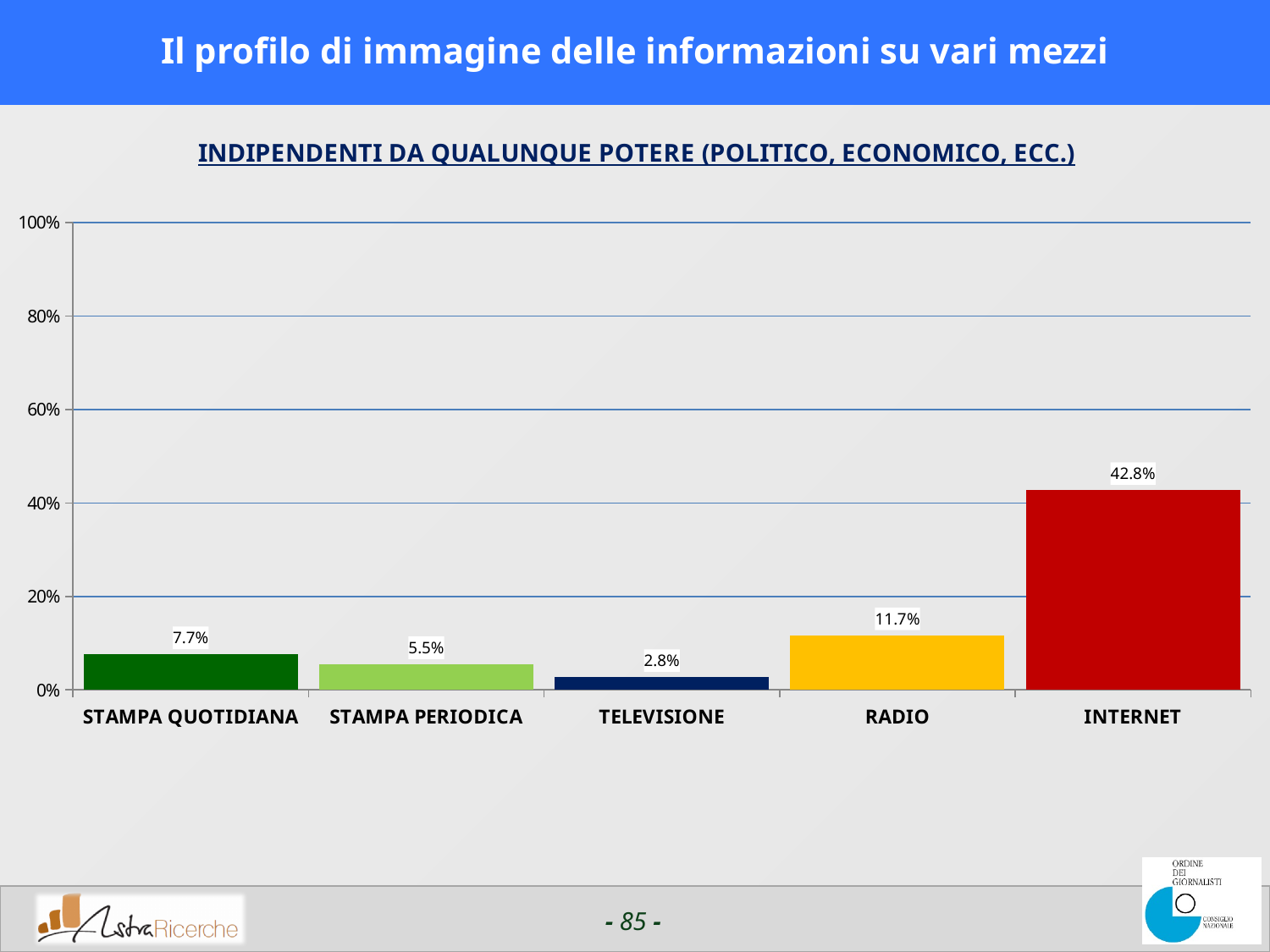
What is the value for INTERNET? 42.8% How many categories are shown on the x axis? 5 What is the value for RADIO? 11.7% Which is larger, the value for RADIO or the value for STAMPA PERIODICA? RADIO What is the value for TELEVISIONE? 2.8% Which category has the lowest value? TELEVISIONE What is the difference between the values for STAMPA QUOTIDIANA and STAMPA PERIODICA? 2.2% Which category has the highest value? INTERNET What kind of chart is shown on the slide? bar chart What is the difference between the values for INTERNET and RADIO? 31.1% What is the value for STAMPA QUOTIDIANA? 7.7% What is the title of the chart? INDIPENDENTI DA QUALUNQUE POTERE (POLITICO, ECONOMICO, ECC.)